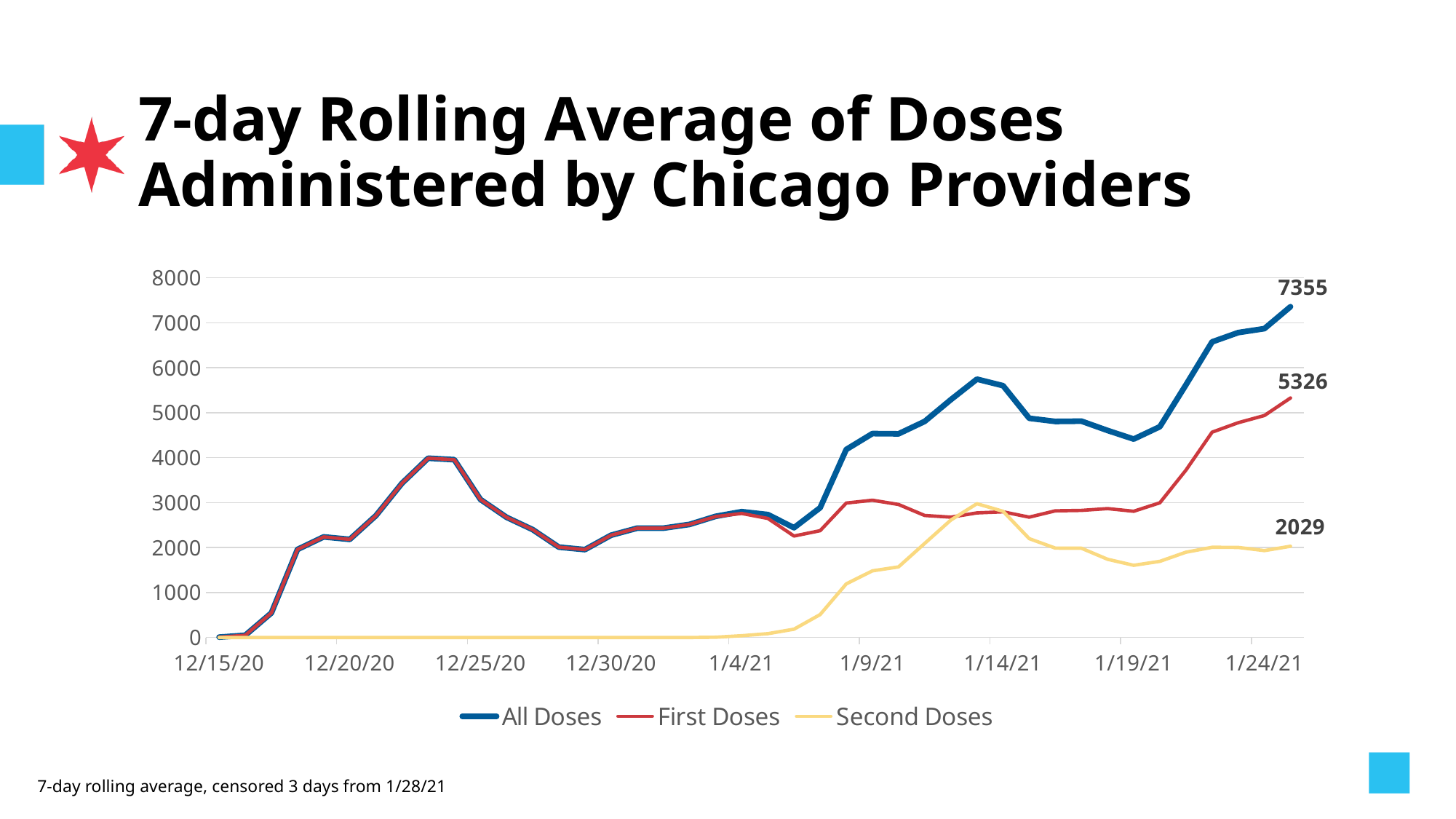
Is the value of the All Doses line at 1/14/21 greater or less than 5000? greater What kind of chart is shown on the slide? Line chart At the end of the chart, which is larger: First Doses or Second Doses? First Doses What is the final labeled value of the Second Doses line? 2029 How many series does the legend list? 3 What is the difference between the final labeled values of All Doses and First Doses? 2029 What is the final labeled value of the First Doses line? 5326 Which series has the highest final labeled value? All Doses Is the value of the Second Doses line at 1/4/21 greater or less than 1000? less What is the difference between the final labeled values of First Doses and Second Doses? 3297 Which series has the lowest final labeled value? Second Doses What is the final labeled value of the All Doses line? 7355